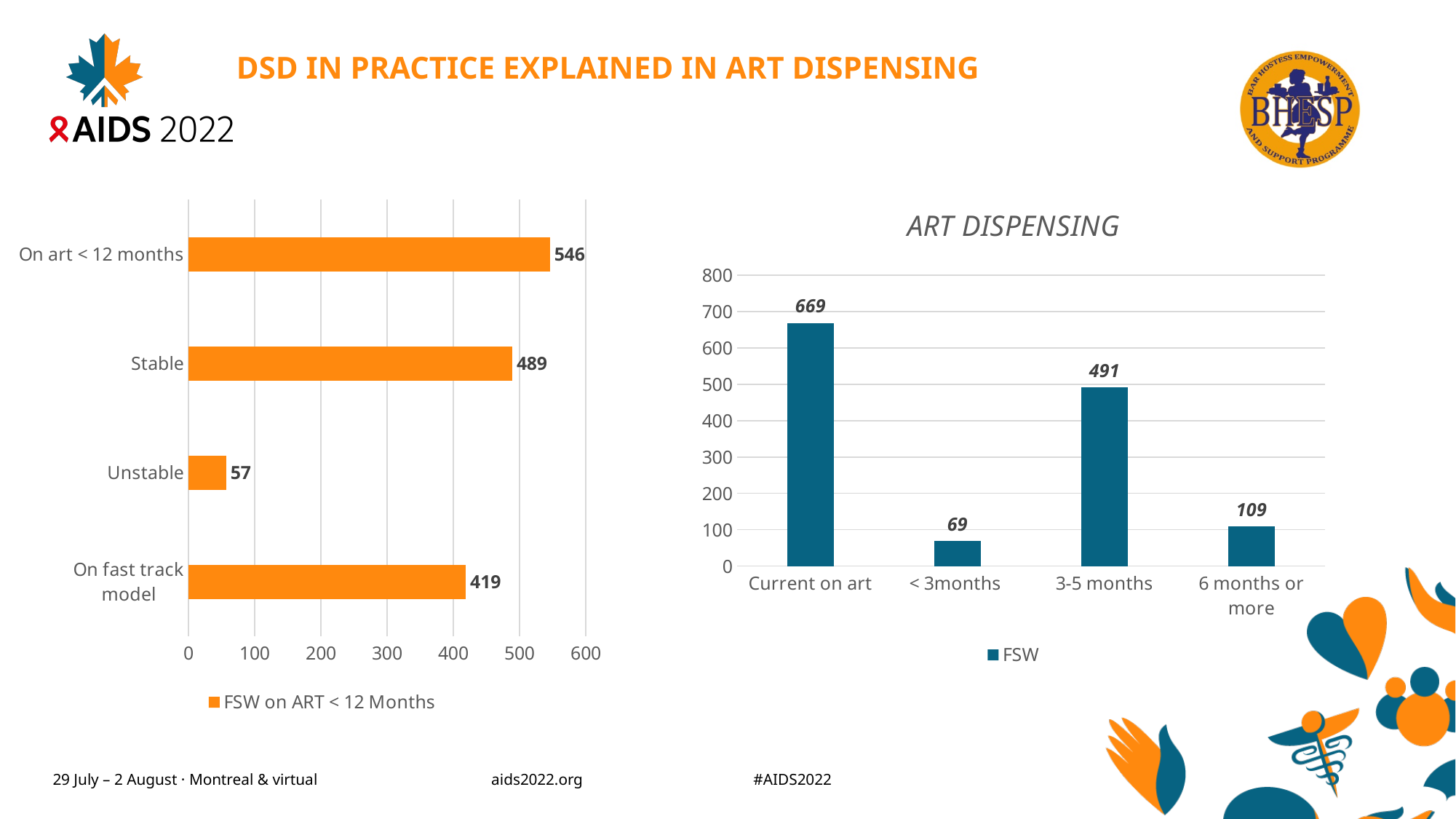
In the left chart, which category has the highest value? On art < 12 months In the ART DISPENSING chart, what is the difference between Current on art and 3-5 months? 178 In the ART DISPENSING chart, what is the value for 6 months or more? 109 In the left chart, what is the difference between On art < 12 months and On fast track model? 127 In the left chart, what series name does the legend show? FSW on ART < 12 Months What kind of chart is the ART DISPENSING chart? Bar chart In the ART DISPENSING chart, which category has the lowest value? < 3months In the ART DISPENSING chart, which is larger, < 3months or 6 months or more? 6 months or more In the left chart, what is the value for Stable? 489 In the left chart, what is the value for Unstable? 57 In the ART DISPENSING chart, what is the value for 3-5 months? 491 In the left chart, how many categories are shown? 4